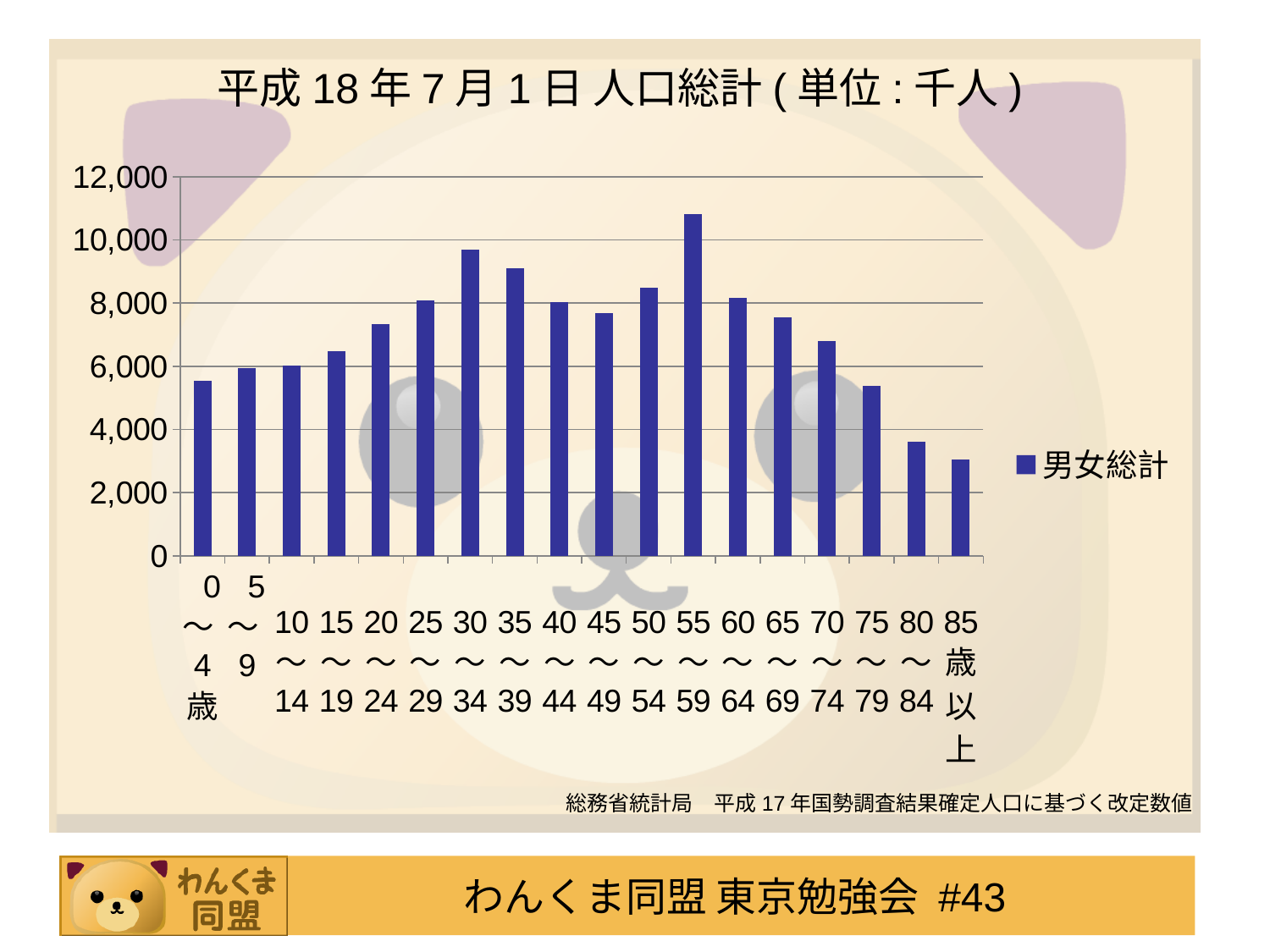
Is the value for the 55～59 age group greater or less than 10,000? greater Which has the larger population, the 75～79 age group or the 80～84 age group? 75～79 Is the value for the 85歳以上 age group greater or less than 4,000? less Which has the larger population, the 30～34 age group or the 45～49 age group? 30～34 How many age groups are plotted in the chart? 18 Which age group has the lowest population in the chart? 85歳以上 What is the name of the series shown in the legend? 男女総計 What kind of chart is shown on the slide? Bar chart Is the value for the 30～34 age group greater or less than 8,000? greater Which age group has the highest population in the chart? 55～59 How many series does the legend list? 1